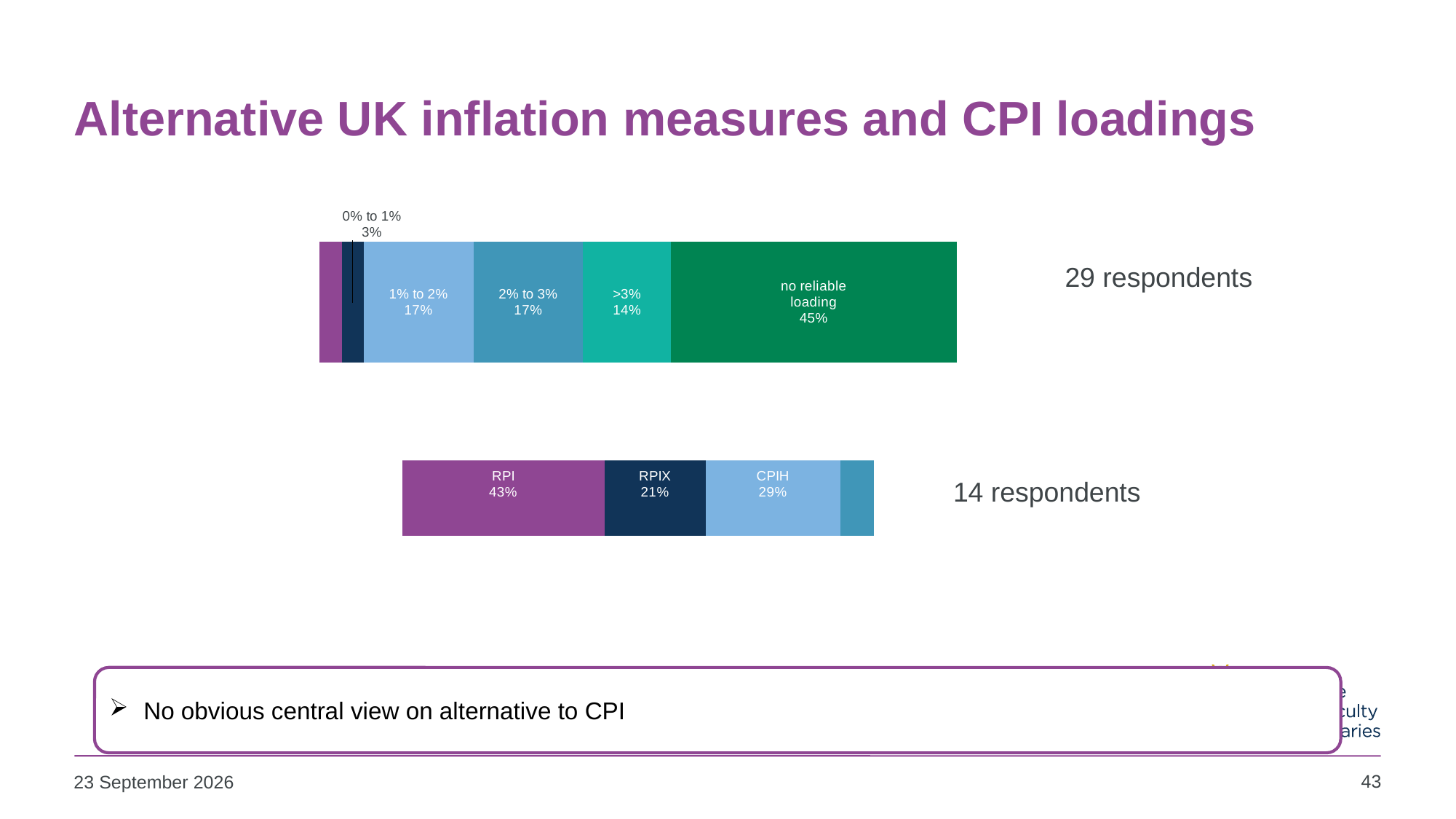
In the top chart (29 respondents), what share of respondents fall in the 1% to 2% loading band? 17% In the bottom chart (14 respondents), what is the difference in percentage points between the RPI share and the RPIX share? 22 percentage points In the bottom chart (14 respondents), what share of respondents chose CPIH? 29% In the top chart (29 respondents), which labelled segment has the largest share? no reliable loading What kind of chart is used for the bottom chart (14 respondents)? Stacked bar chart In the top chart (29 respondents), which labelled segment has the smallest share? 0% to 1% In the bottom chart (14 respondents), what share of respondents chose RPI? 43% In the bottom chart (14 respondents), which is larger, the RPIX share or the CPIH share? CPIH In the top chart (29 respondents), what share of respondents reported no reliable loading? 45% In the top chart (29 respondents), what is the difference in percentage points between the 'no reliable loading' share and the '>3%' share? 31 percentage points In the top chart (29 respondents), what share of respondents fall in the 0% to 1% loading band? 3% In the top chart (29 respondents), what share of respondents fall in the >3% loading band? 14%